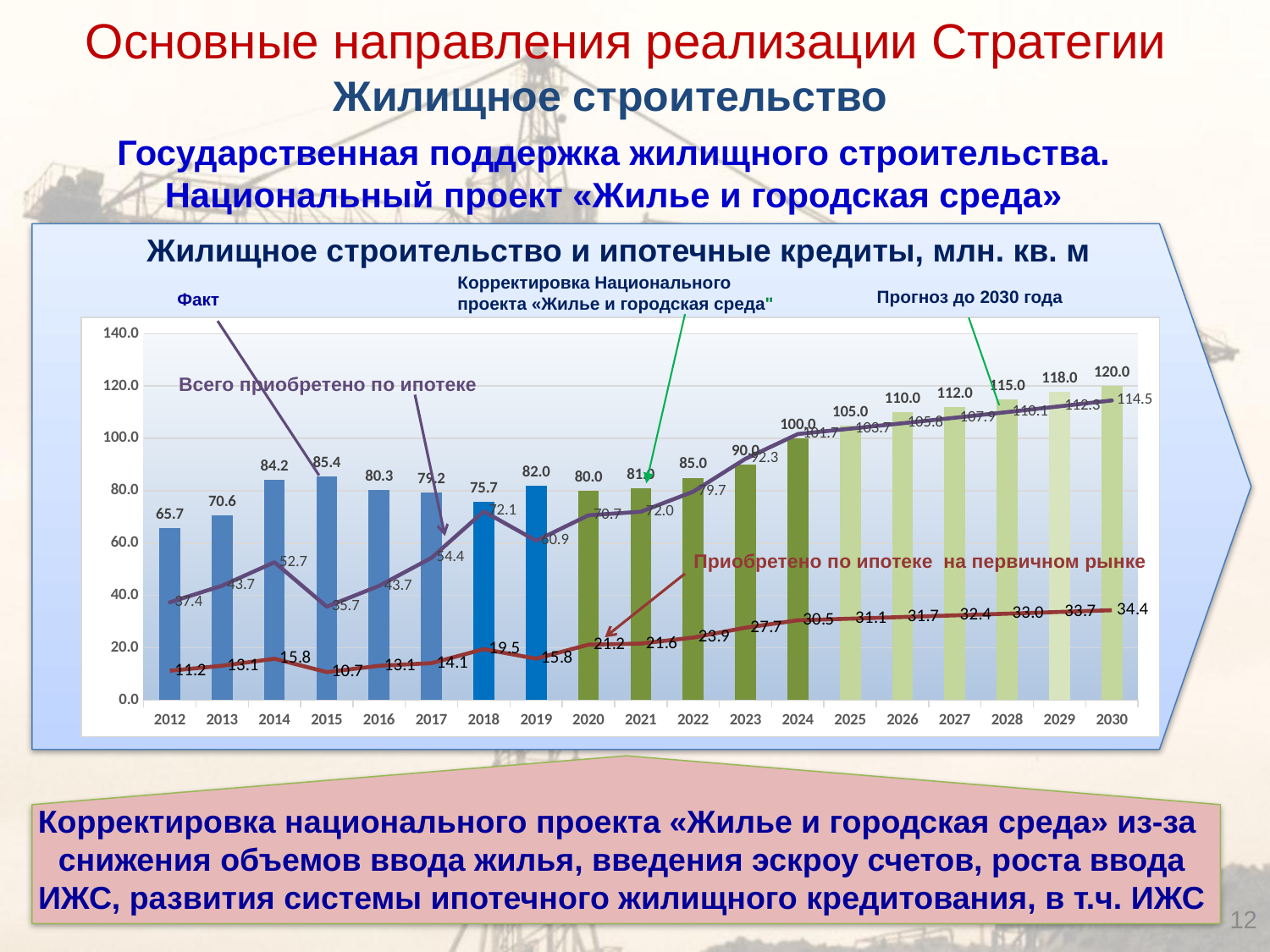
Does the line 'Приобретено по ипотеке на первичном рынке' generally rise or fall from 2020 to 2030? Rise What is the bar value for 2024? 100.0 What is the bar value for 2012? 65.7 What is the title of the chart on the slide? Жилищное строительство и ипотечные кредиты, млн. кв. м What is the difference between the bar values for 2030 and 2012? 54.3 How many years are shown on the x axis of the chart? 19 What is the value of the line 'Всего приобретено по ипотеке' for 2018? 72.1 Which year has the lowest bar value? 2012 What type of chart is shown on the slide? A combined bar and line chart Which year has the larger bar value, 2014 or 2015? 2015 Which year has the highest bar value? 2030 What is the value of the line 'Приобретено по ипотеке на первичном рынке' for 2030? 34.4